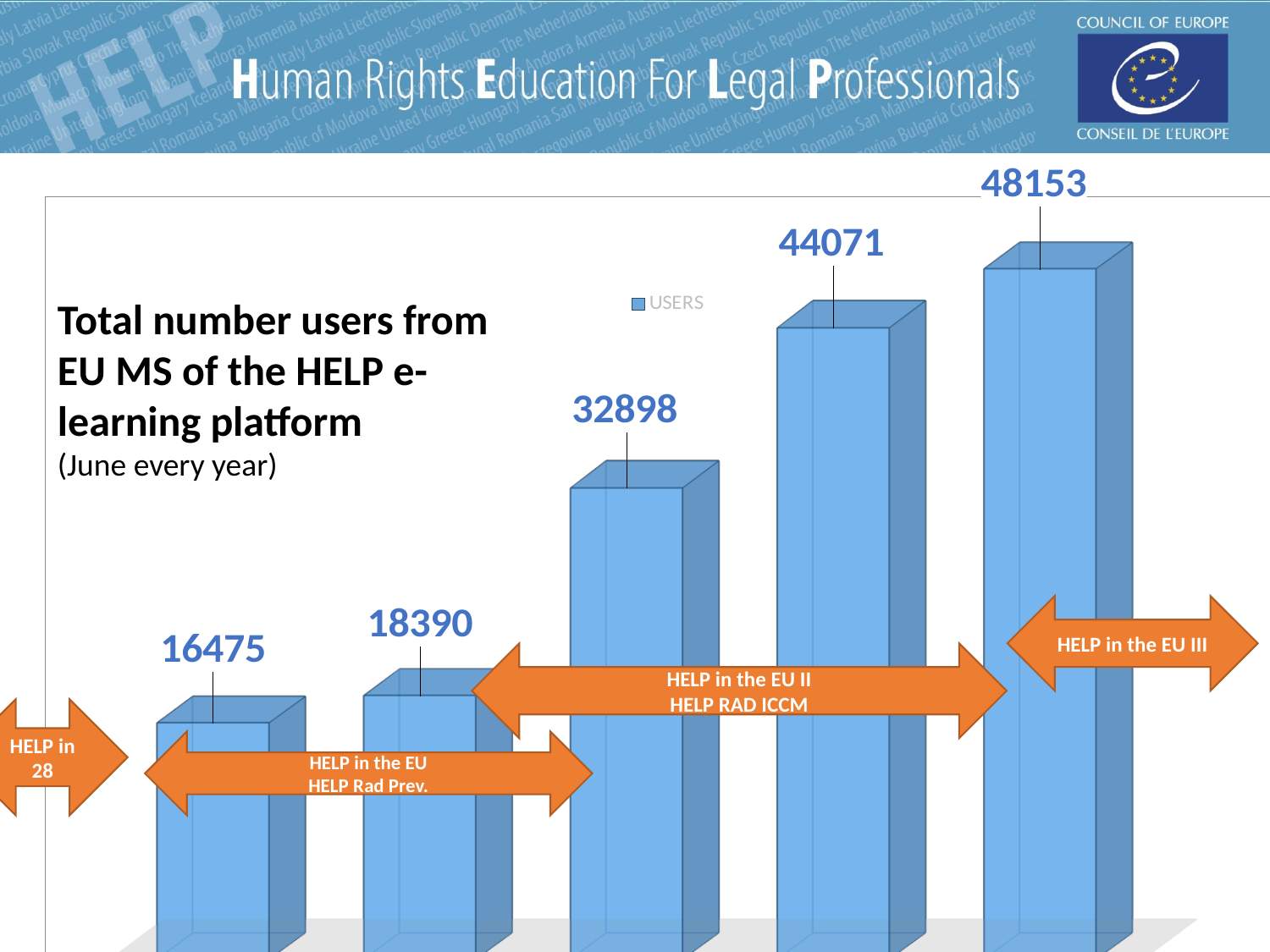
Which bar has the highest value? the rightmost (fifth) bar, 48153 What is the value of the second bar from the left? 18390 What is the name of the series shown in the chart legend? USERS What is the value of the fourth bar from the left? 44071 What kind of chart is shown on the slide? bar chart What is the value of the last (rightmost) bar? 48153 How many bars are plotted in the chart? 5 Do the values rise or fall from left to right across the bars? rise What is the value of the first (leftmost) bar? 16475 What is the value of the middle (third) bar? 32898 What is the difference between the rightmost bar and the leftmost bar? 31678 How many series does the chart legend list? 1